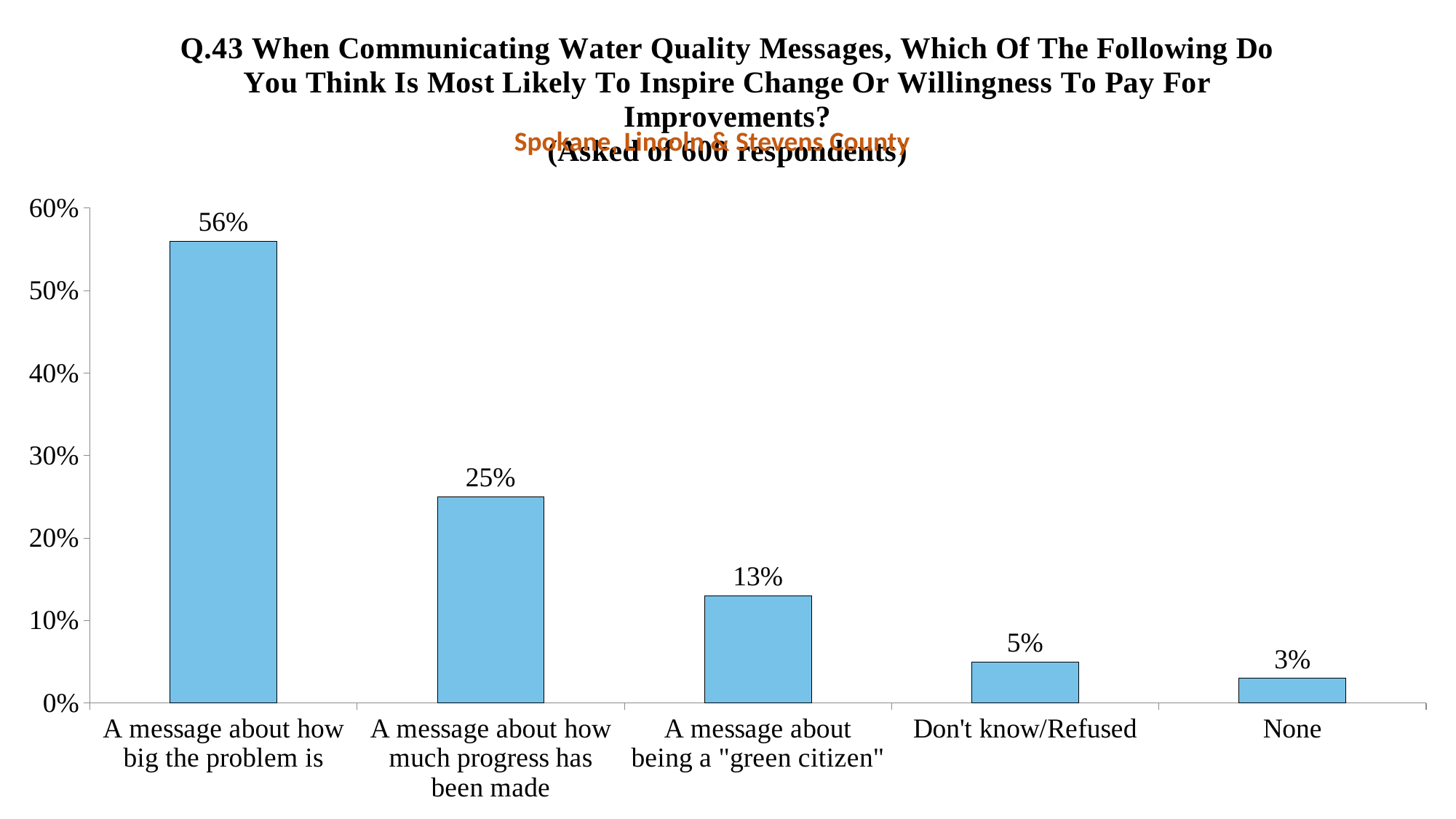
What is the difference between "A message about how big the problem is" and "A message about how much progress has been made"? 31% What percentage of respondents chose "A message about how big the problem is"? 56% What percentage chose "A message about being a "green citizen""? 13% Is the value for "A message about how big the problem is" greater or less than 50%? greater How many categories are shown on the chart? 5 What kind of chart is shown on the slide? Bar chart What is the value for "Don't know/Refused"? 5% Which category has the lowest value? None Which category has the highest value? A message about how big the problem is How many respondents were asked this question, according to the chart title? 600 What is the value for "A message about how much progress has been made"? 25% Which is larger: "A message about being a "green citizen"" or "Don't know/Refused"? A message about being a "green citizen"